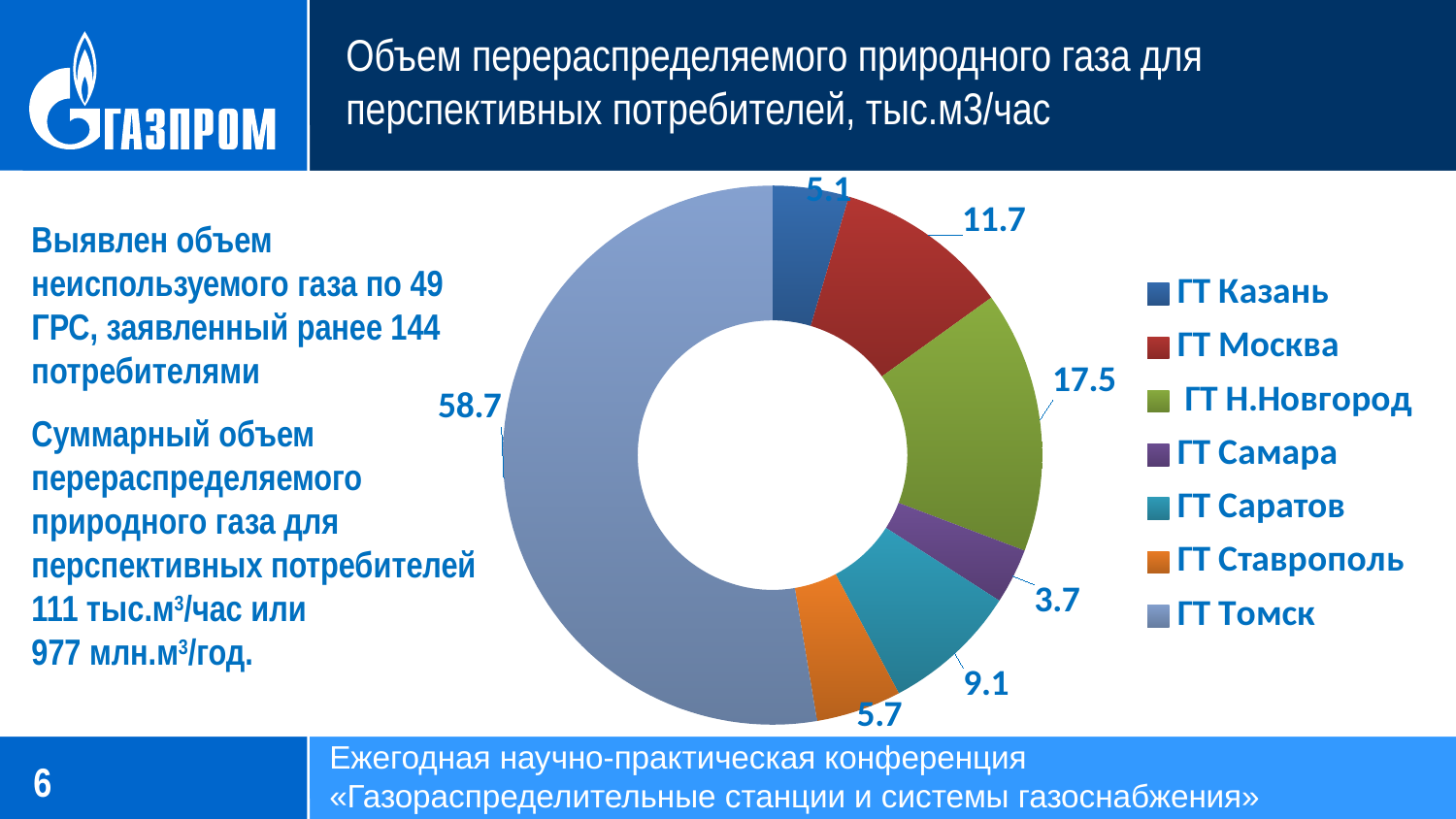
What is the value for ГТ Томск? 58.7 Which category has the smallest value? ГТ Самара What is the value for ГТ Н.Новгород? 17.5 What is the value for ГТ Москва? 11.7 How many categories does the chart show? 7 What type of chart is shown on the slide? Pie chart (doughnut) What is the difference between the values for ГТ Томск and ГТ Казань? 53.6 Which is larger, the value for ГТ Саратов or the value for ГТ Ставрополь? ГТ Саратов What is the value for ГТ Самара? 3.7 Which category has the largest value? ГТ Томск What is the difference between the values for ГТ Н.Новгород and ГТ Москва? 5.8 What colour is the ГТ Ставрополь slice? Orange